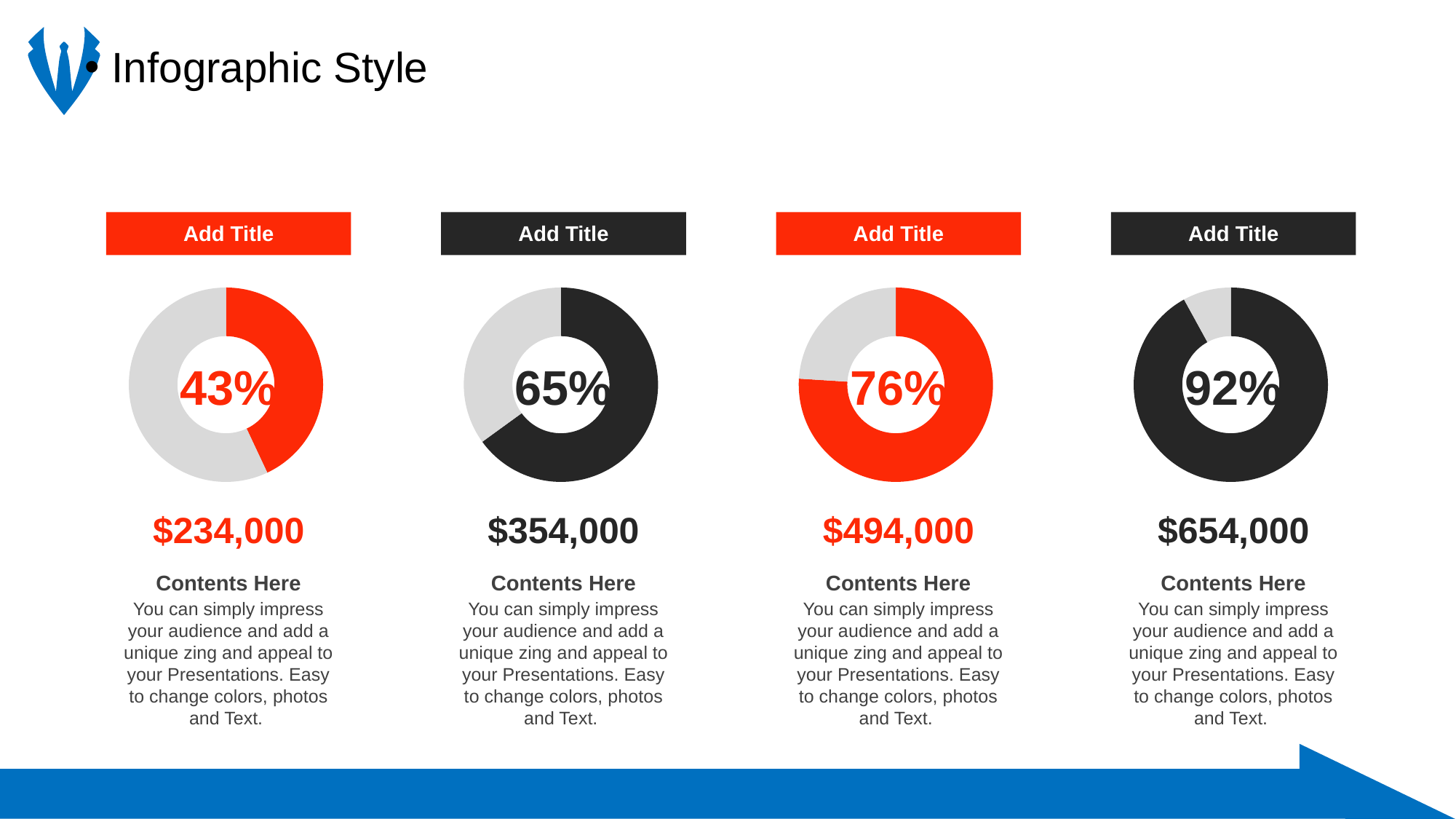
What percentage is shown in the centre of the rightmost donut chart? 92% Which of the four donut charts shows the highest percentage? The rightmost (92%) What percentage is shown in the centre of the third donut chart from the left? 76% Which of the four donut charts shows the lowest percentage? The leftmost (43%) What is the difference between the percentage in the rightmost donut chart and the percentage in the leftmost donut chart? 49% How many donut charts are on the slide? 4 What dollar value is printed below the leftmost donut chart? $234,000 What percentage is shown in the centre of the second donut chart from the left? 65% What colour is the filled portion of the third donut chart from the left? Red What dollar value is printed below the rightmost donut chart? $654,000 What percentage is shown in the centre of the leftmost donut chart? 43% Which is larger: the percentage in the second donut chart from the left or the percentage in the third donut chart from the left? The third from the left (76%)